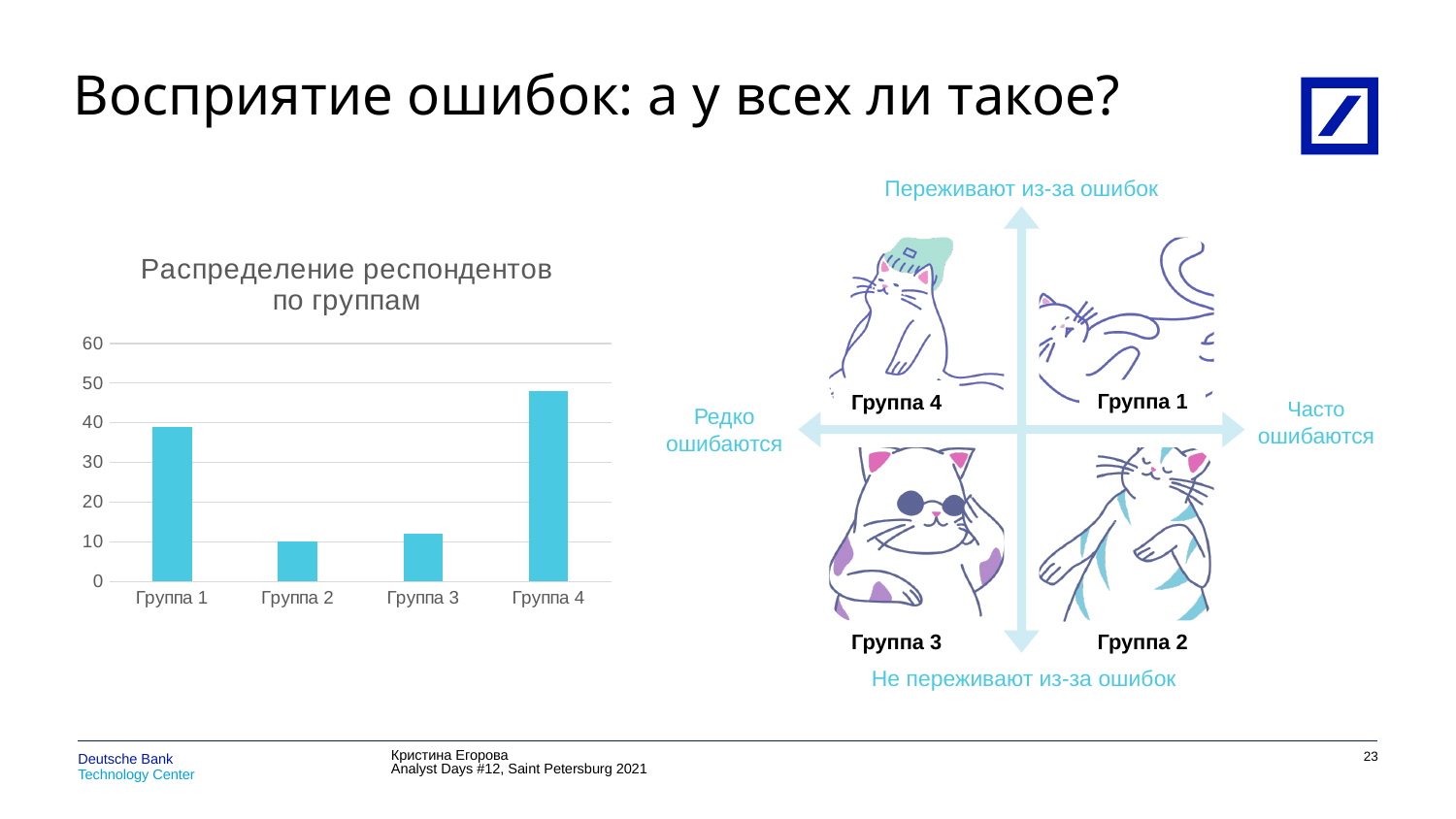
Is the value for Группа 3 greater or less than 20? less How many groups are shown on the x axis of the chart? 4 What is the highest value shown on the y axis of the chart? 60 Which is larger, the value for Группа 1 or the value for Группа 4? Группа 4 What is the value for Группа 2? 10 Which group has the highest number of respondents? Группа 4 Which group has the lowest number of respondents? Группа 2 Is the value for Группа 4 greater or less than 40? greater Is the value for Группа 1 greater or less than 50? less What is the title of the chart? Распределение респондентов по группам What kind of chart is shown on the slide? bar chart